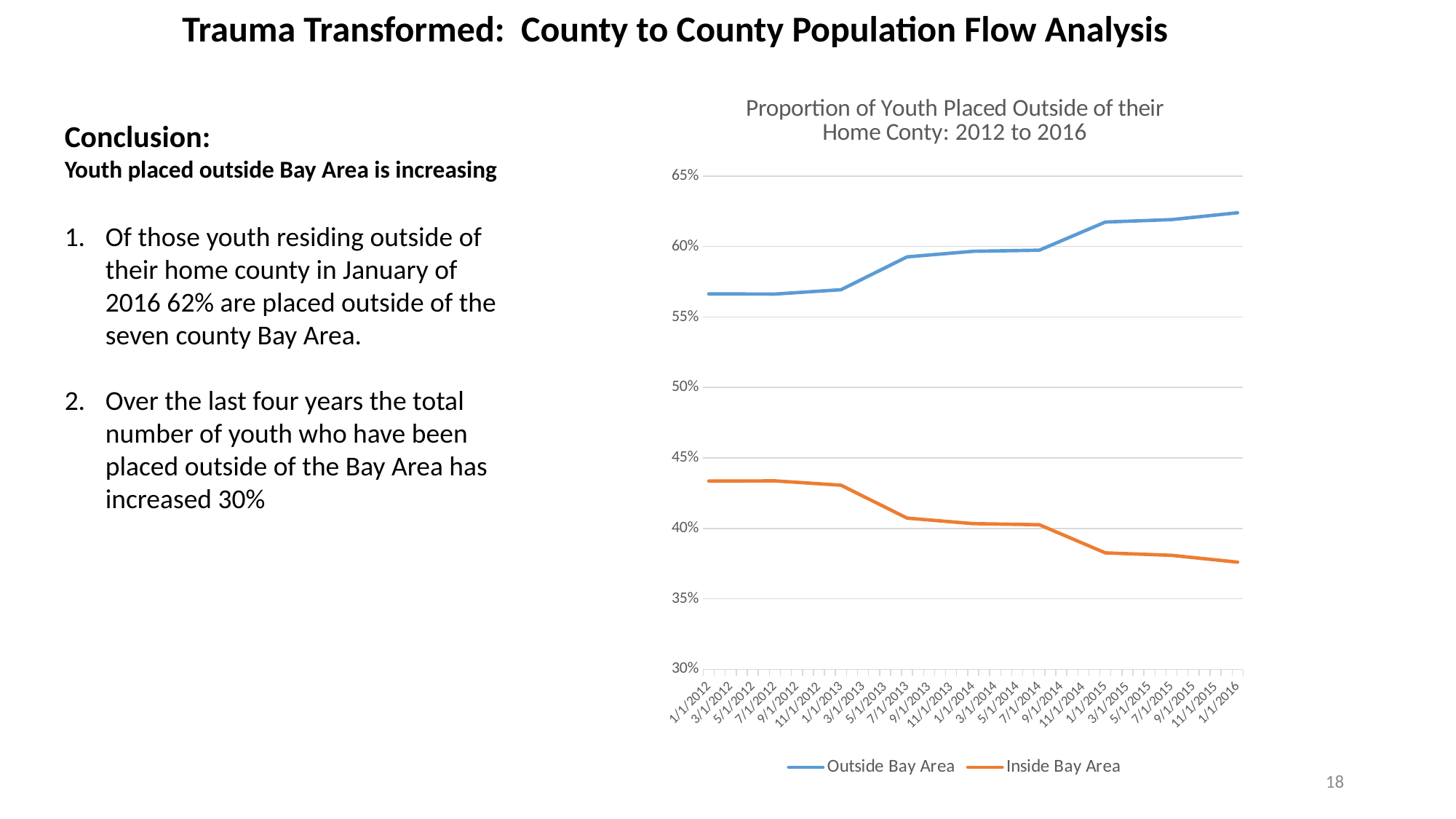
Which series has the higher value at 1/1/2016, Outside Bay Area or Inside Bay Area? Outside Bay Area Is the value for Inside Bay Area at 1/1/2016 greater or less than 40%? less How many series does the chart's legend list? 2 Is the value for Inside Bay Area at 1/1/2012 greater or less than 45%? less What kind of chart is shown on the slide? line chart At which date does the Inside Bay Area series reach its lowest value? 1/1/2016 What are the two series named in the chart's legend? Outside Bay Area and Inside Bay Area Is the value for Outside Bay Area at 1/1/2012 greater or less than 55%? greater Does the Inside Bay Area series rise or fall from 1/1/2012 to 1/1/2016? fall Does the Outside Bay Area series rise or fall from 1/1/2012 to 1/1/2016? rise What is the title of the chart? Proportion of Youth Placed Outside of their Home Conty: 2012 to 2016